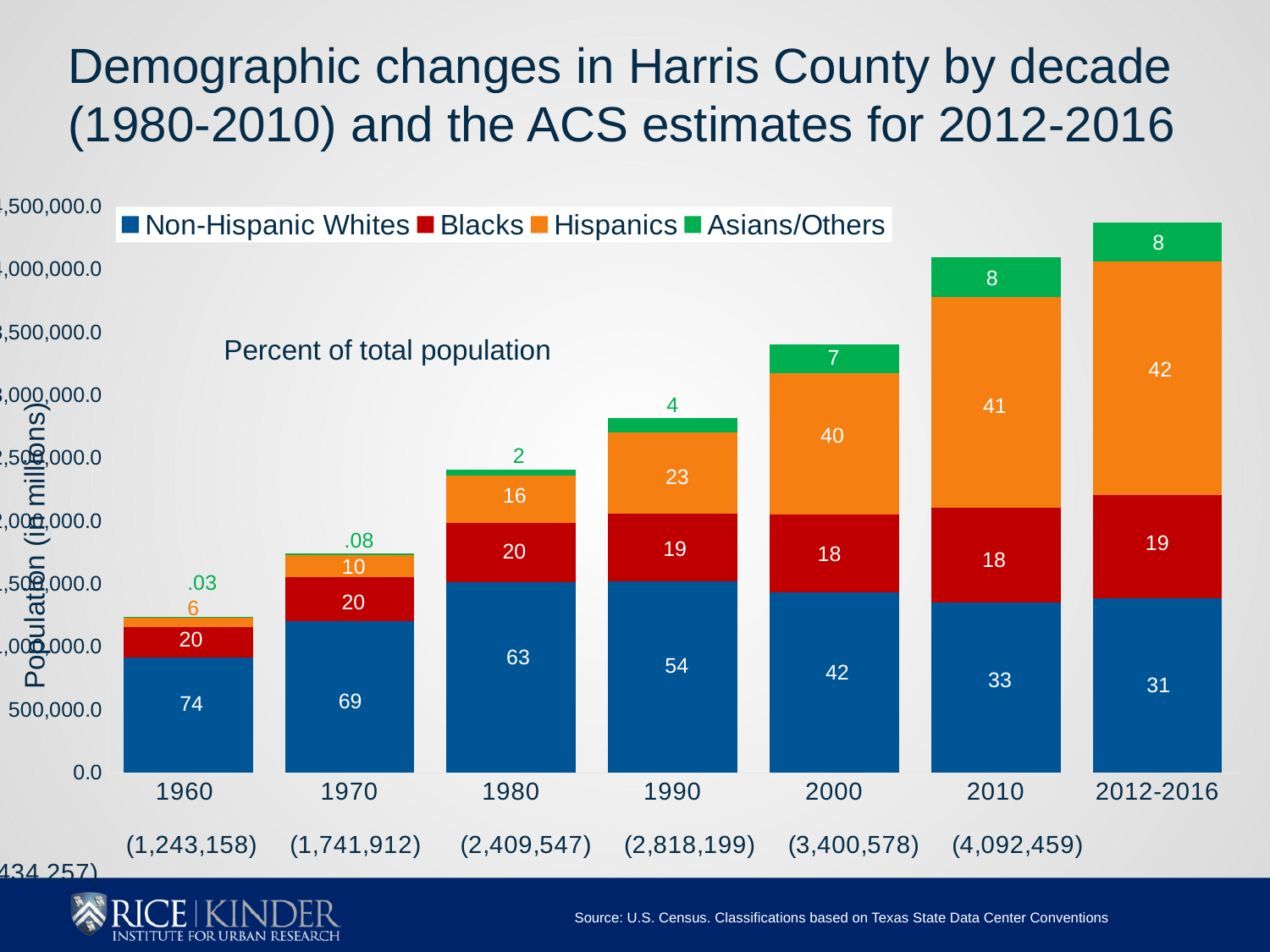
What is the Non-Hispanic Whites percentage label for 1960? 74 What total population is printed beneath the 2000 bar? (3,400,578) Which period has the lowest Non-Hispanic Whites percentage label? 2012-2016 What is the Hispanics percentage label for 2012-2016? 42 Which year has the highest Non-Hispanic Whites percentage label? 1960 In 1990, which group has the larger percentage label, Hispanics or Blacks? Hispanics Is the total height of the 1990 bar greater or less than 3,000,000? less Does the Non-Hispanic Whites percentage rise or fall from 1960 to 2012-2016? fall How many series does the legend list? 4 By how many percentage points does the Hispanics label for 2000 exceed the Hispanics label for 1990? 17 What kind of chart is shown on the slide? stacked bar chart How many time periods are shown on the x axis? 7